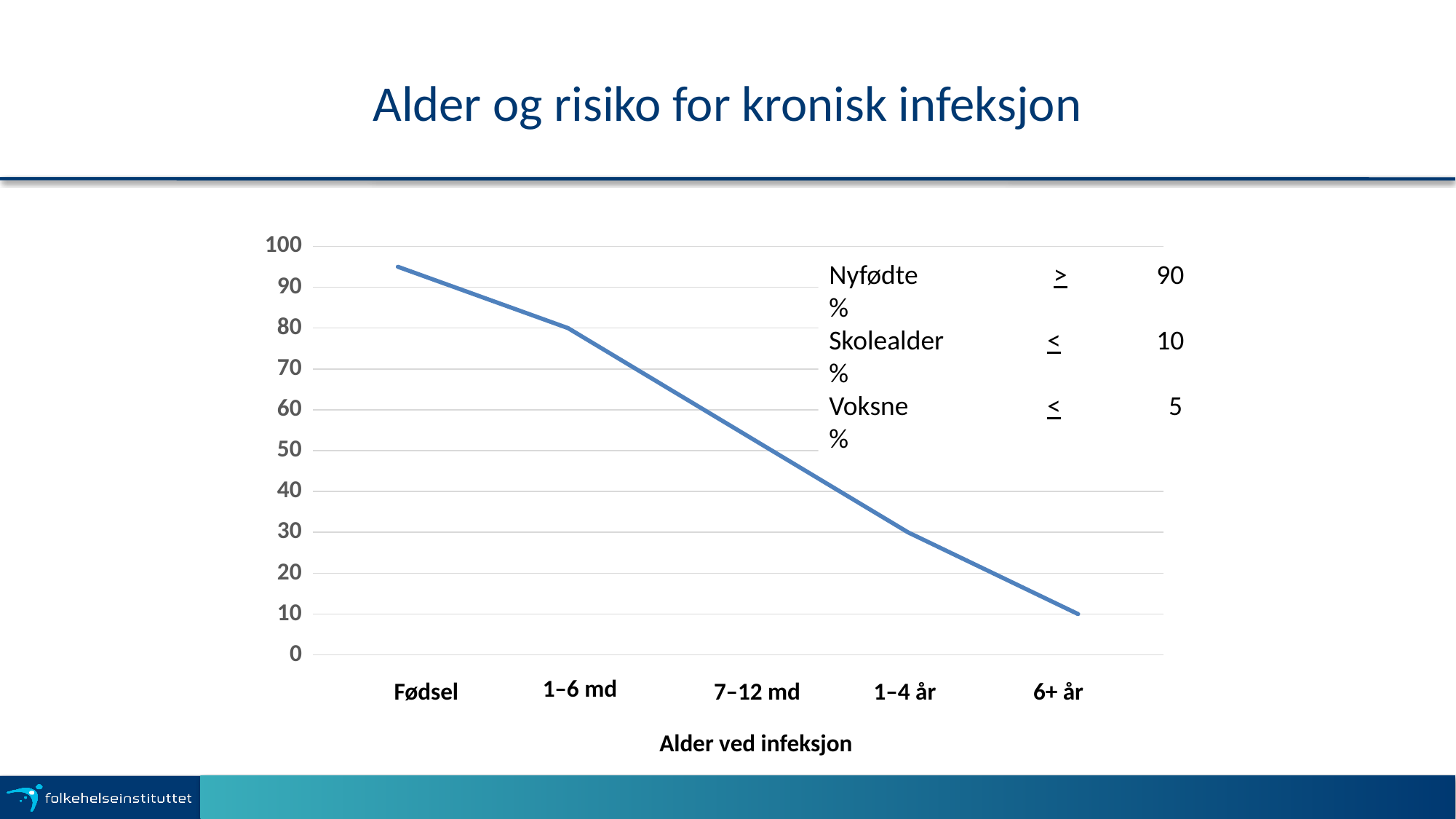
What is the value for 1–4 år? 30 How many age categories are plotted along the x axis? 5 Which age category has the lowest value? 6+ år Is the value for Fødsel greater or less than 90? greater What is the value for 6+ år? 10 Is the value for 7–12 md greater or less than 60? less What is the value for 1–6 md? 80 Which age category has the highest value? Fødsel Do the values rise or fall as age at infection increases along the x axis? fall Which has a larger value, 1–6 md or 1–4 år? 1–6 md What is the title of the x axis? Alder ved infeksjon What kind of chart is shown on the slide? line chart